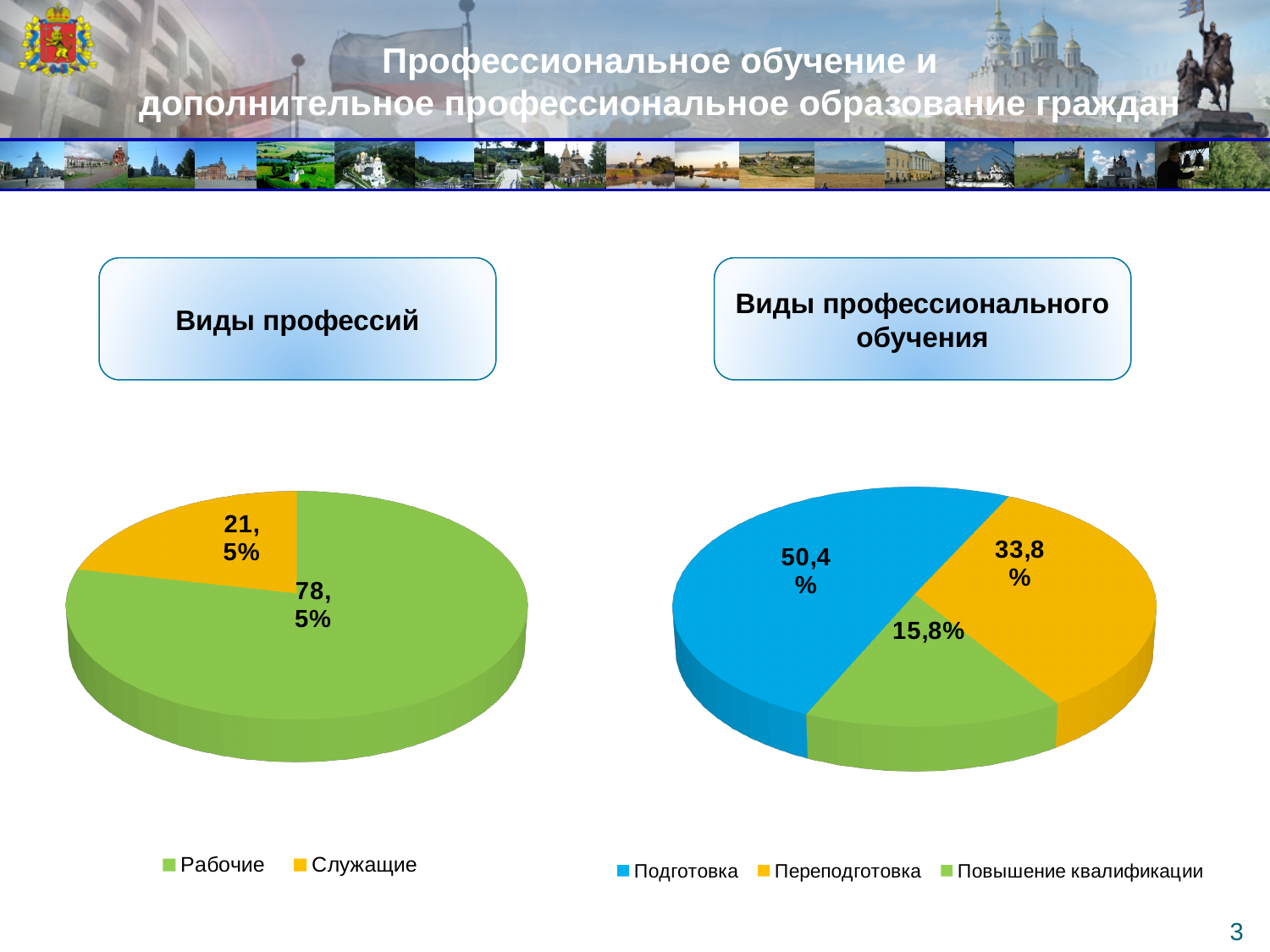
In the 'Виды профессионального обучения' chart, which category has the smallest slice? Повышение квалификации In the 'Виды профессионального обучения' chart, which is larger: Подготовка or Переподготовка? Подготовка In the 'Виды профессионального обучения' chart, what colour is the Подготовка slice? Blue In the 'Виды профессий' chart, what share is labelled for Служащие? 21,5% In the 'Виды профессионального обучения' chart, what share is labelled for Подготовка? 50,4% What kind of chart is the 'Виды профессий' chart? Pie chart How many categories does the legend of the 'Виды профессий' chart list? 2 In the 'Виды профессионального обучения' chart, what share is labelled for Переподготовка? 33,8% In the 'Виды профессий' chart, what share is labelled for Рабочие? 78,5% In the 'Виды профессий' chart, which category has the largest slice? Рабочие In the 'Виды профессионального обучения' chart, what share is labelled for Повышение квалификации? 15,8% In the 'Виды профессий' chart, what is the difference between the Рабочие and Служащие shares? 57 percentage points